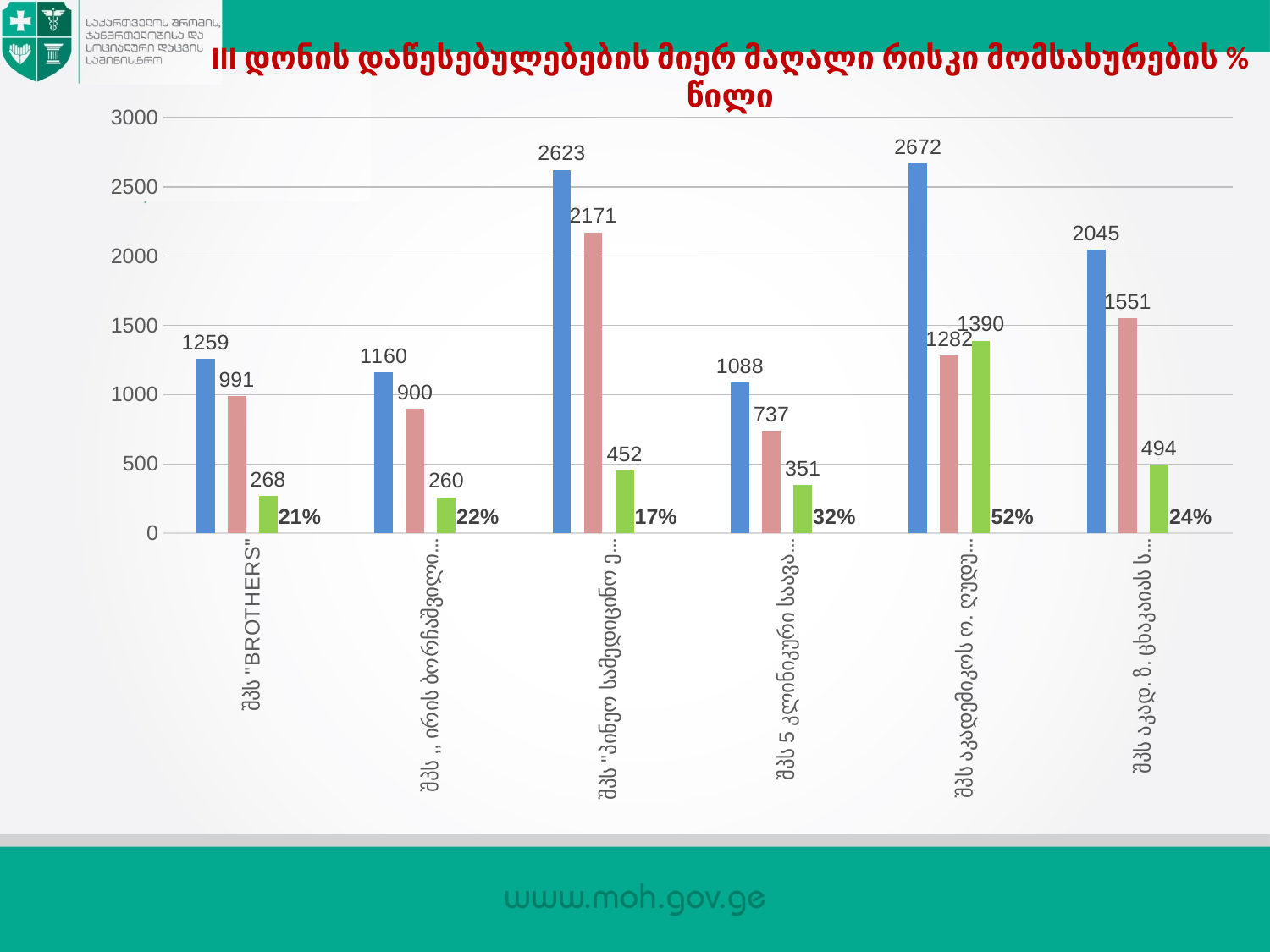
What is the highest value shown on the vertical axis of the chart? 3000 Which category has the lowest green (third) bar? შპს ,, ირის ბორჩაშვილი... Which category has the highest percentage label printed on the chart? შპს აკადემიკოს ო. ღუდუ... (52%) What percentage is printed next to the bars for შპს 5 კლინიკური საავა...? 32% What is the value of the blue (first) bar for შპს "BROTHERS"? 1259 What kind of chart is shown on the slide? bar chart Which is larger for შპს აკადემიკოს ო. ღუდუ...: the pink bar or the green bar? the green bar (1390) What is the value of the green (third) bar for შპს "BROTHERS"? 268 How many categories (hospitals) are shown on the x axis of the chart? 6 Which category has the highest blue (first) bar? შპს აკადემიკოს ო. ღუდუ...